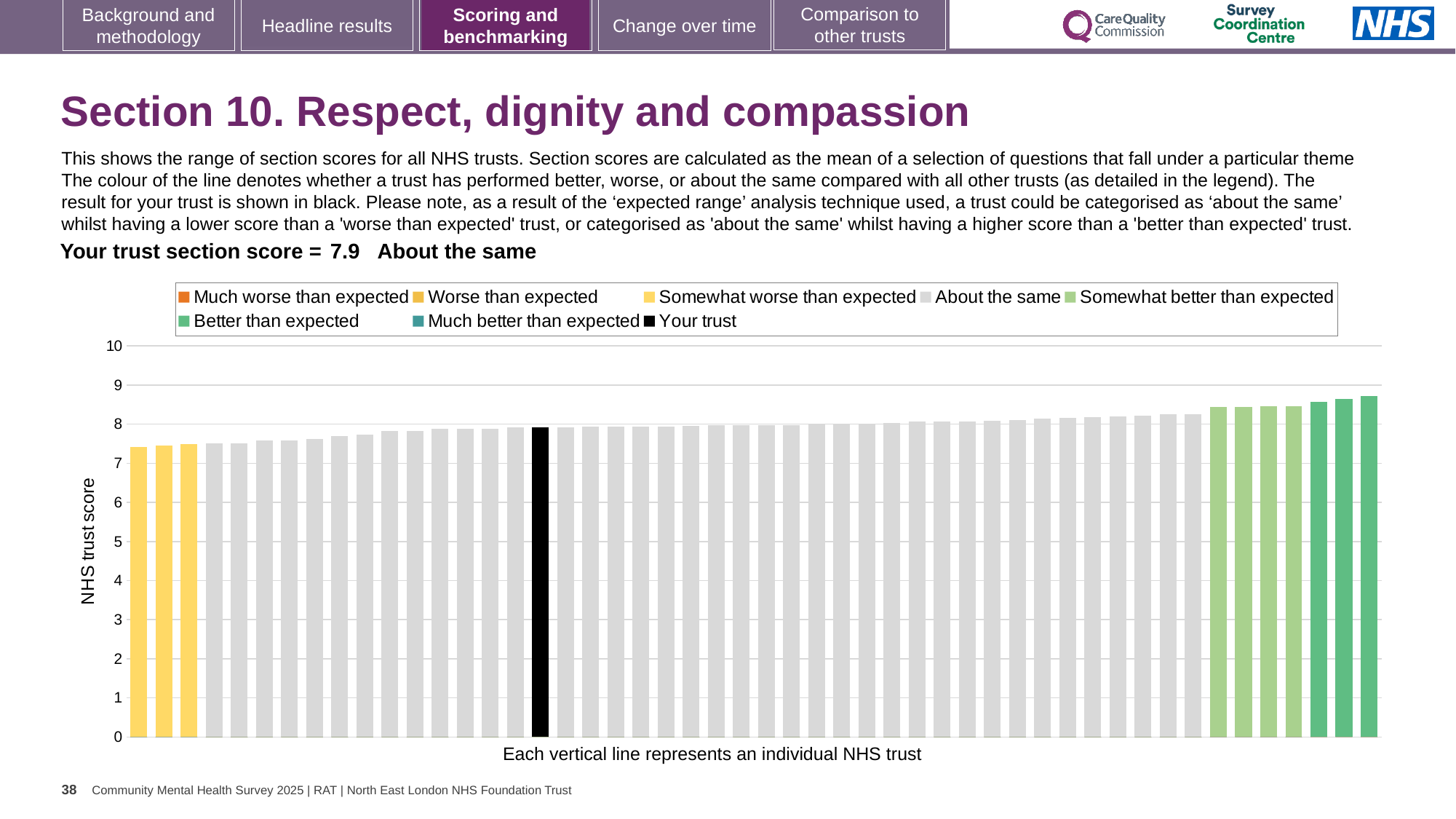
What is the label on the vertical axis of the chart? NHS trust score What kind of chart is shown on the slide? bar chart Is the value for your trust (the black bar) greater or less than 5? greater How many bars are coloured yellow (Somewhat worse than expected)? 3 Which category is your trust placed in for this section? About the same What colour is the bar representing your trust? black Do the bar values rise or fall from left to right along the x axis? rise What is the section score for your trust shown on the slide? 7.9 How many entries does the chart legend list? 8 Is the value of the tallest bar greater or less than 8? greater Is the value of the leftmost bar greater or less than 8? less How many bars are coloured dark green (Better than expected)? 3